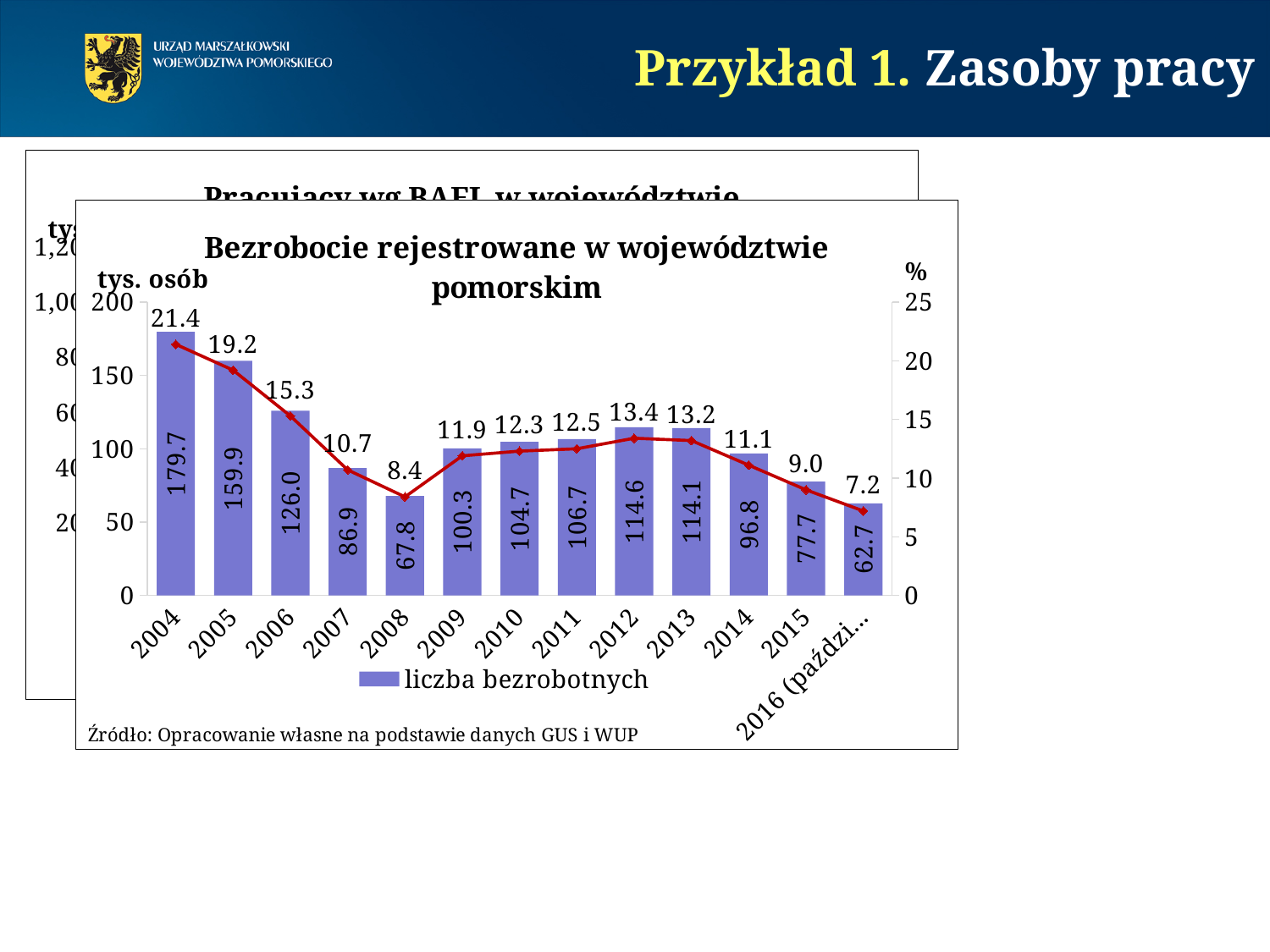
In the chart titled 'Bezrobocie rejestrowane w województwie pomorskim', what is the difference between the number of unemployed in 2004 and in 2005? 19.8 In the chart titled 'Bezrobocie rejestrowane w województwie pomorskim', what percentage value does the line show for 2008? 8.4 In the chart titled 'Bezrobocie rejestrowane w województwie pomorskim', what is the number of unemployed (liczba bezrobotnych) for 2004? 179.7 In the chart titled 'Bezrobocie rejestrowane w województwie pomorskim', is the number of unemployed for 2006 greater or less than 100? greater In the chart titled 'Bezrobocie rejestrowane w województwie pomorskim', what percentage value does the line show for 2016 (październik)? 7.2 In the chart titled 'Bezrobocie rejestrowane w województwie pomorskim', which year has the highest number of unemployed? 2004 In the chart titled 'Bezrobocie rejestrowane w województwie pomorskim', how many years are shown on the x axis? 13 In the chart titled 'Bezrobocie rejestrowane w województwie pomorskim', what is the number of unemployed (liczba bezrobotnych) for 2012? 114.6 In the chart titled 'Bezrobocie rejestrowane w województwie pomorskim', what kind of chart is used for the 'liczba bezrobotnych' series? bar chart In the chart titled 'Bezrobocie rejestrowane w województwie pomorskim', which year has the lowest number of unemployed? 2016 (październik) In the chart titled 'Bezrobocie rejestrowane w województwie pomorskim', does the percentage line rise or fall from 2013 to 2016 (październik)? fall In the chart titled 'Bezrobocie rejestrowane w województwie pomorskim', which year has the larger number of unemployed, 2007 or 2009? 2009